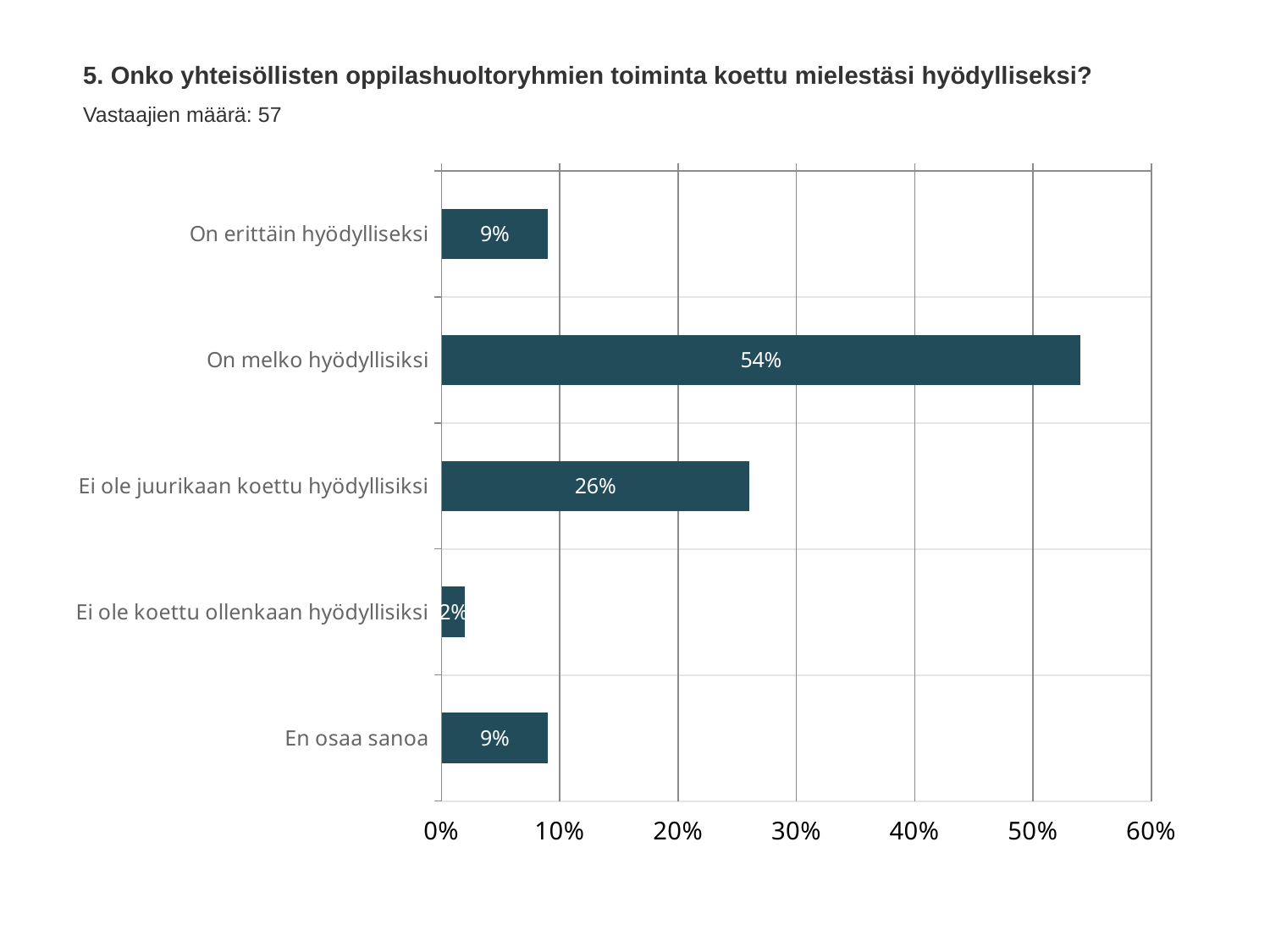
What is the value for "On melko hyödyllisiksi"? 54% Is the value for "On melko hyödyllisiksi" greater or less than 50%? greater What is the value for "Ei ole juurikaan koettu hyödyllisiksi"? 26% What kind of chart is shown on the slide? bar chart Which category has the highest value? On melko hyödyllisiksi Which category has the lowest value? Ei ole koettu ollenkaan hyödyllisiksi How many respondents (Vastaajien määrä) are reported on the slide? 57 What is the value for "Ei ole koettu ollenkaan hyödyllisiksi"? 2% How many categories are shown in the chart? 5 Which is larger, the value for "Ei ole juurikaan koettu hyödyllisiksi" or the value for "On erittäin hyödylliseksi"? Ei ole juurikaan koettu hyödyllisiksi What is the difference between the values for "On melko hyödyllisiksi" and "Ei ole juurikaan koettu hyödyllisiksi"? 28% What is the value for "En osaa sanoa"? 9%